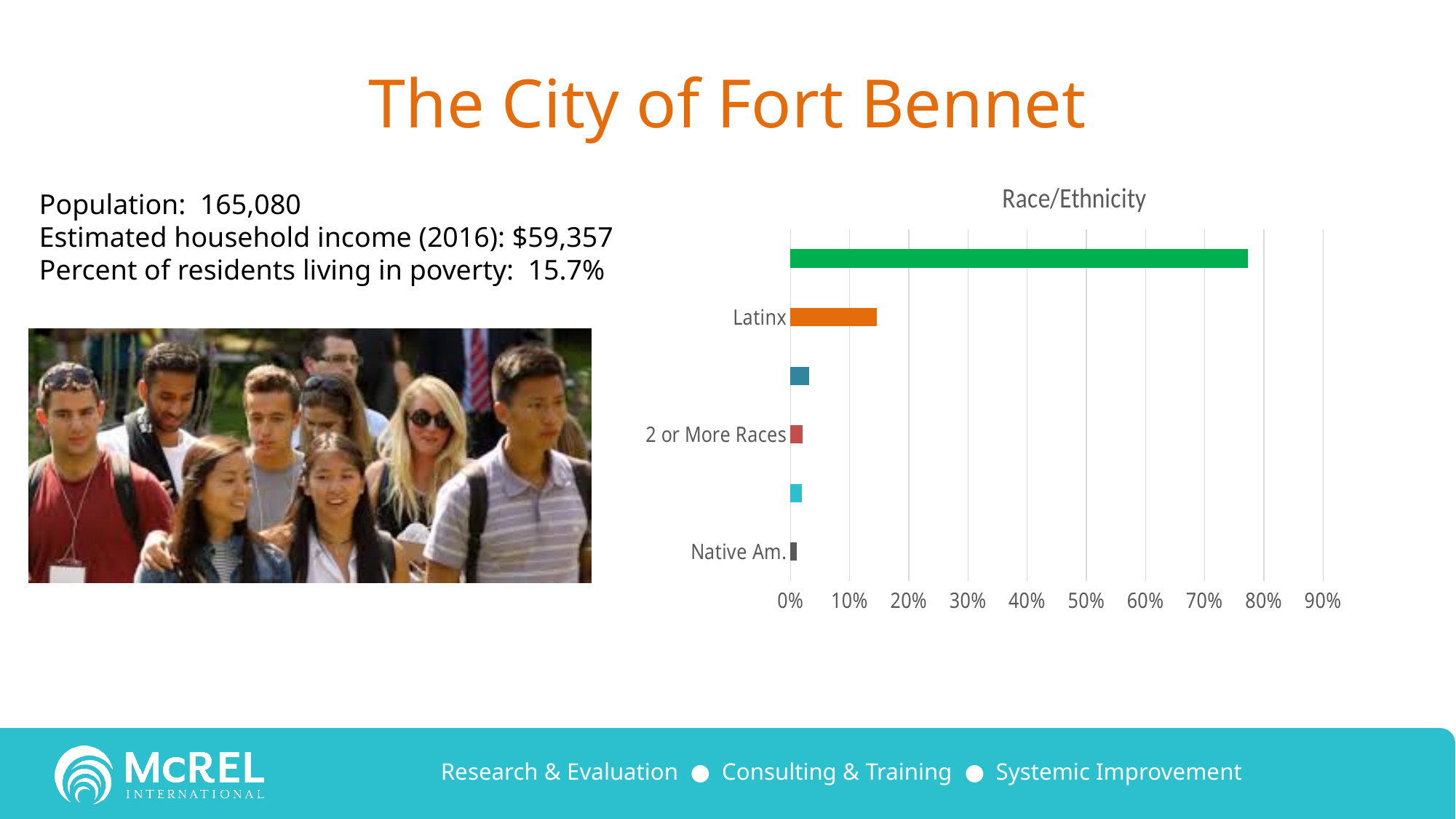
What kind of chart is shown on the slide? bar chart Is the value for 2 or More Races greater or less than 10%? less What is the title of the chart? Race/Ethnicity Which has the larger value, Latinx or 2 or More Races? Latinx Is the value for Latinx greater or less than 10%? greater Is the value for Latinx greater or less than 20%? less Which has the larger value, Latinx or Native Am.? Latinx What colour is the Latinx bar? orange What is the highest value shown on the chart's horizontal axis? 90% How many bars are plotted in the Race/Ethnicity chart? 6 Which category has the lowest value in the chart? Native Am.